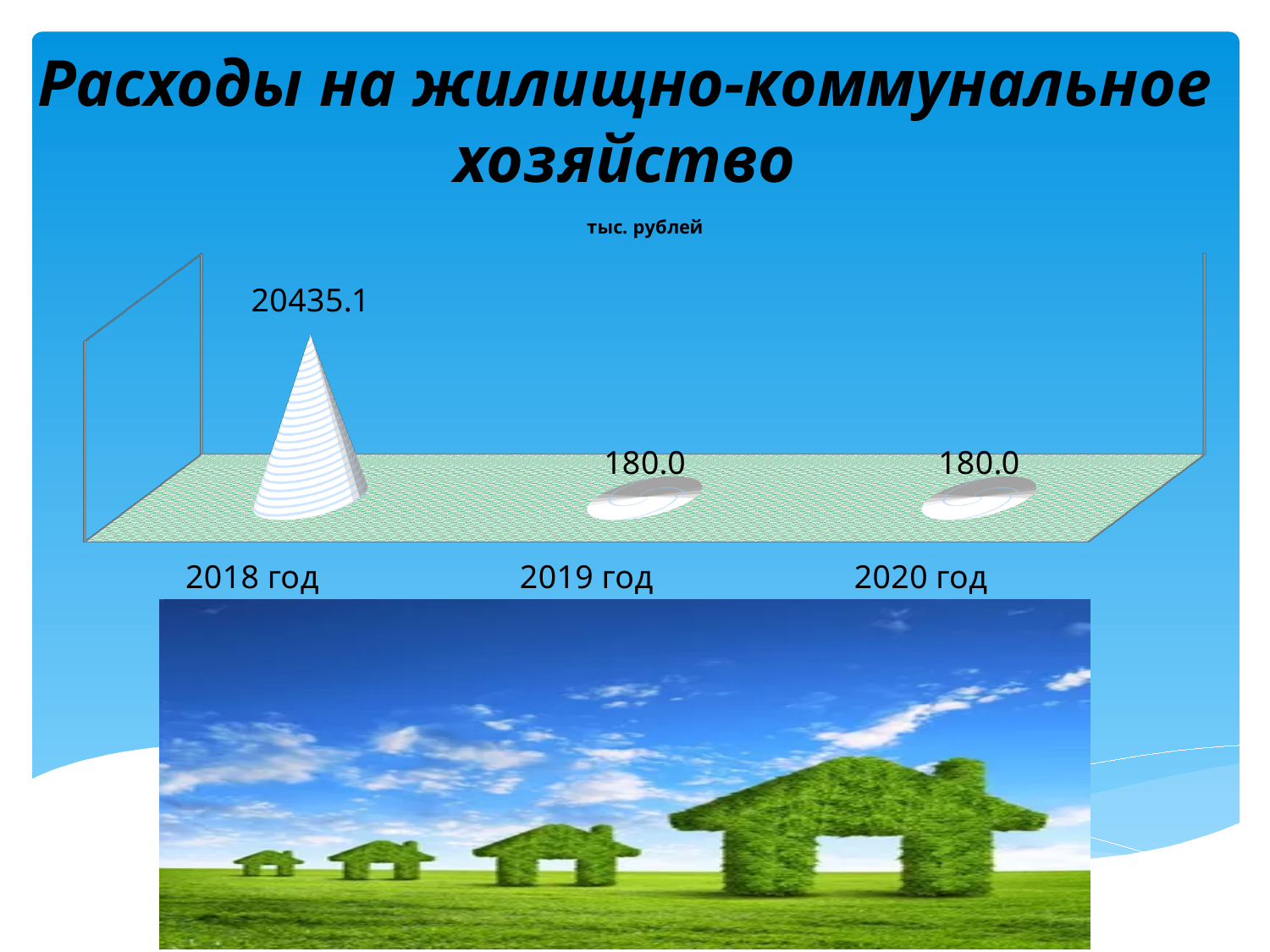
Which year has the highest value? 2018 год What is the title of the chart? тыс. рублей What is the value for 2019 год? 180.0 What kind of chart is shown on the slide? bar chart Are the values for 2019 год and 2020 год equal? yes What is the value for 2018 год? 20435.1 Do the values rise or fall from 2018 год to 2019 год? fall What is the value for 2020 год? 180.0 In what units are the chart values given? тыс. рублей How many years are shown on the chart? 3 Which is larger, the value for 2018 год or the value for 2020 год? 2018 год What is the difference between the values for 2018 год and 2019 год? 20255.1